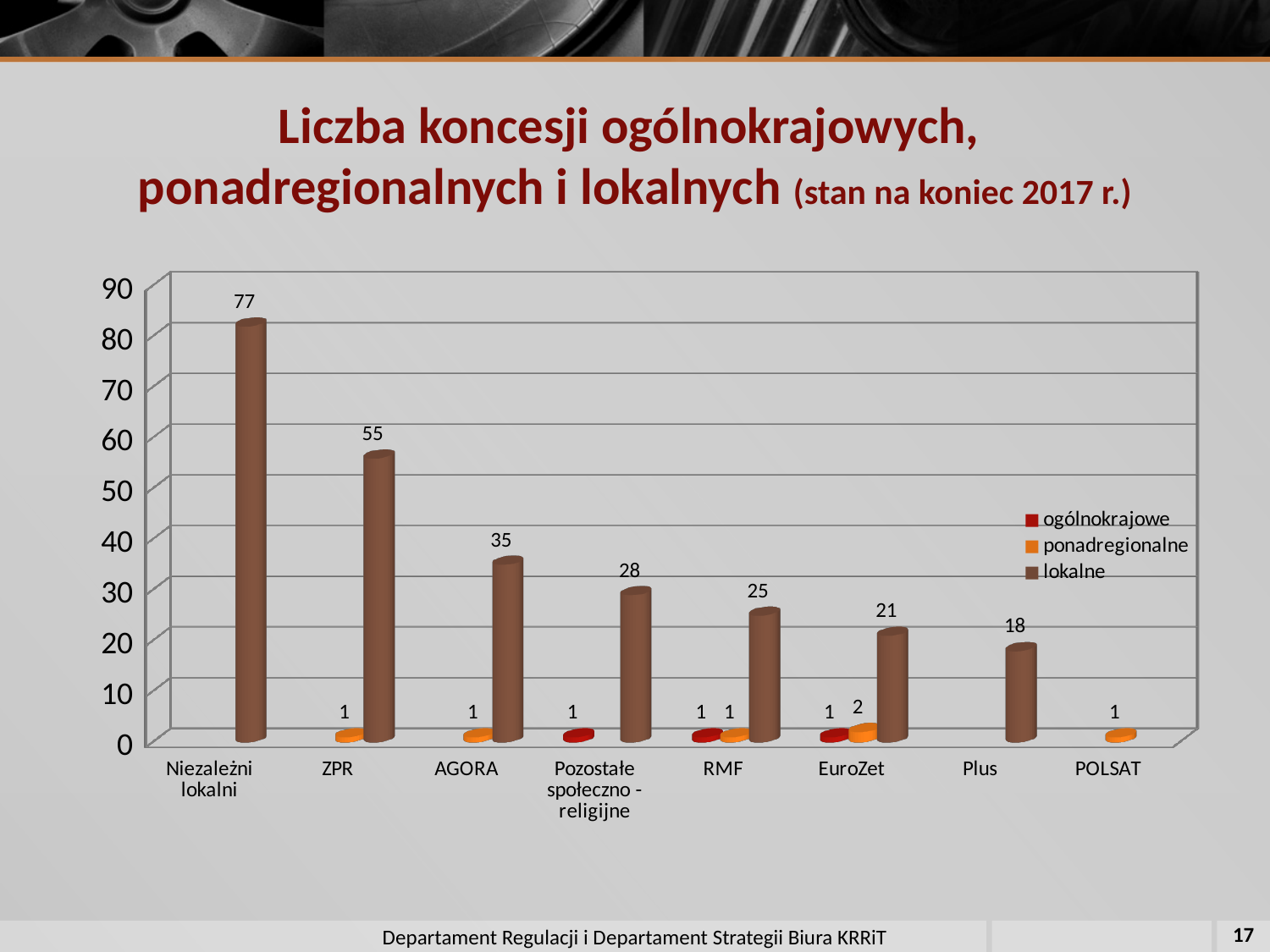
Which category has the highest lokalne value? Niezależni lokalni What kind of chart is shown on the slide? Bar chart What is the value of the lokalne series for Plus? 18 What is the value of the ponadregionalne series for EuroZet? 2 What is the value of the lokalne series for Niezależni lokalni? 77 How many categories are shown on the x axis? 8 Which is larger, the lokalne value for RMF or for EuroZet? RMF What is the difference between the lokalne values for ZPR and AGORA? 20 Which category has the lowest lokalne value among those with a lokalne bar? Plus How many series does the legend list? 3 What is the value of the lokalne series for ZPR? 55 Which series is shown in orange in the legend? ponadregionalne